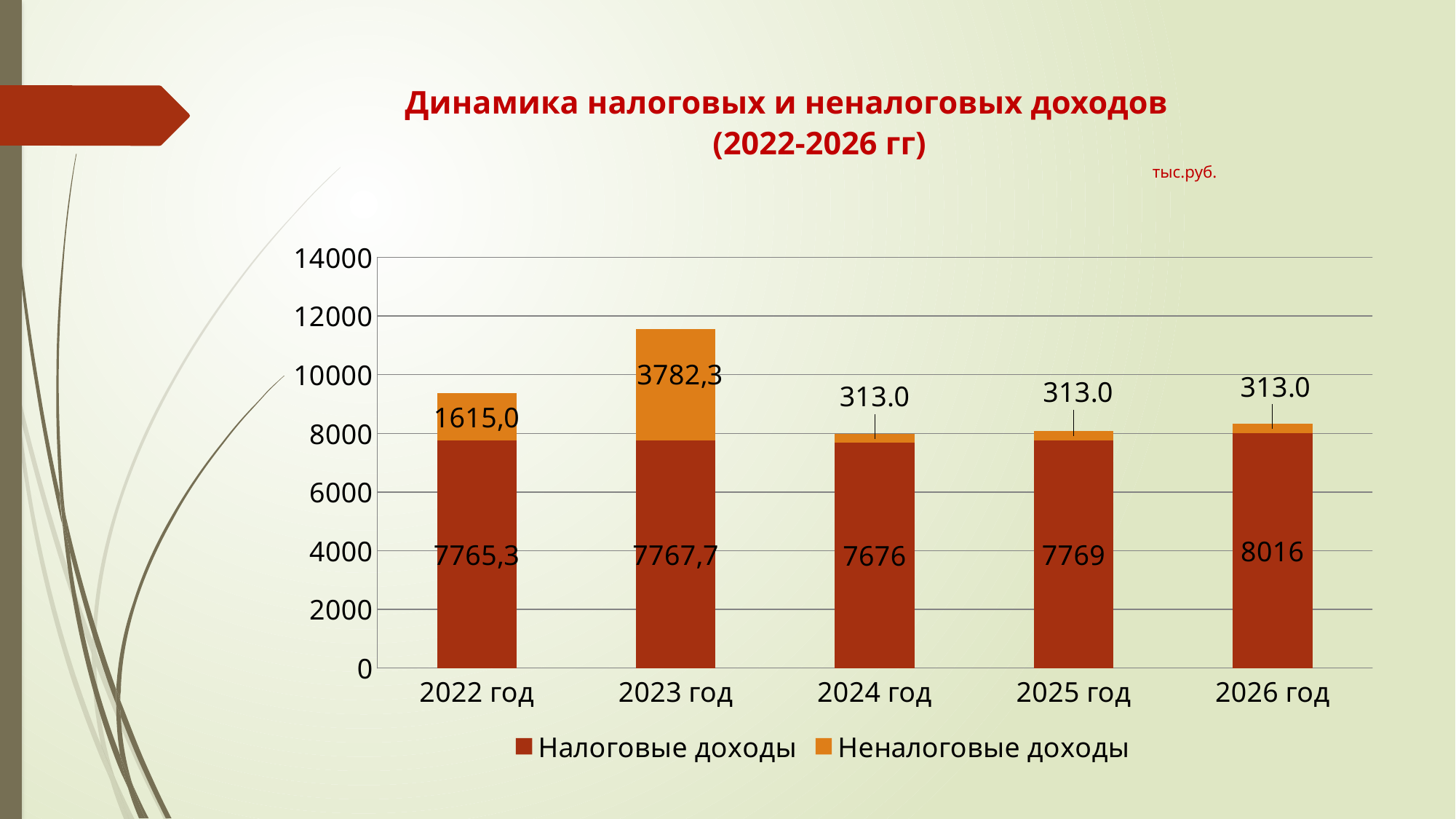
What is the value of Неналоговые доходы for 2023 год? 3782,3 How many series does the legend list? 2 What is the difference between Неналоговые доходы in 2023 год and in 2022 год? 2167,3 What is the value of Налоговые доходы for 2026 год? 8016 What is the value of Налоговые доходы for 2022 год? 7765,3 Which year has the highest value of Неналоговые доходы? 2023 год Which is larger: Налоговые доходы in 2025 год or in 2024 год? 2025 год Is the total of the stacked bar for 2023 год greater or less than 10000? greater What is the total of the stacked bar for 2024 год? 7989 Which year has the highest value of Налоговые доходы? 2026 год What type of chart is shown on the slide? Stacked bar chart Which year has the lowest value of Налоговые доходы? 2024 год